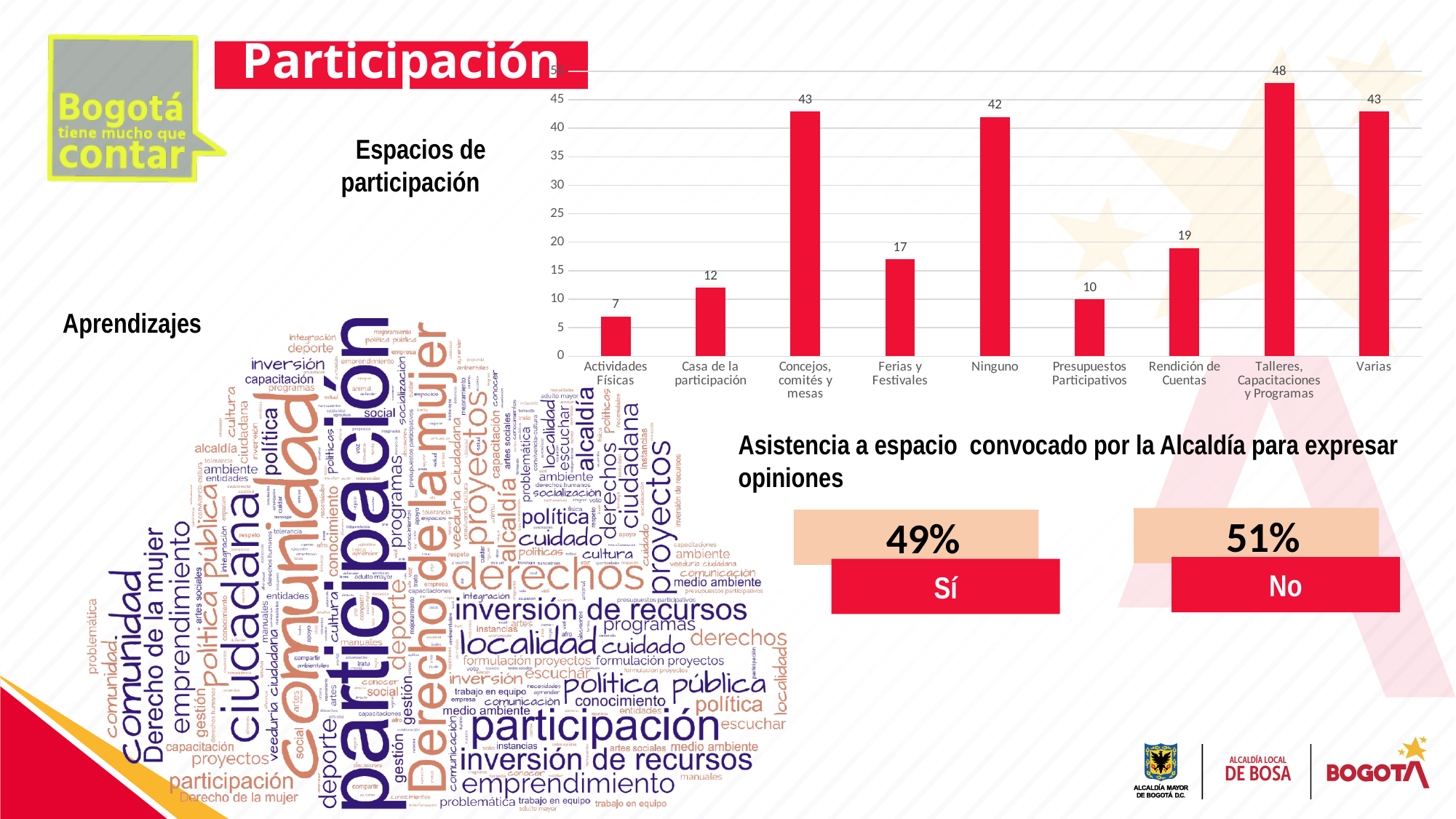
How many categories are shown in the 'Espacios de participación' bar chart? 9 In the 'Espacios de participación' bar chart, what is the difference between the values for Talleres, Capacitaciones y Programas and Casa de la participación? 36 In the 'Asistencia a espacio convocado por la Alcaldía para expresar opiniones' graphic, which is larger: Sí or No? No In the 'Espacios de participación' bar chart, is the value for Varias greater or less than 40? greater In the 'Espacios de participación' bar chart, which category has the lowest value? Actividades Físicas In the 'Espacios de participación' bar chart, what is the value for Presupuestos Participativos? 10 In the 'Espacios de participación' bar chart, what is the value for Ferias y Festivales? 17 In the 'Asistencia a espacio convocado por la Alcaldía para expresar opiniones' graphic, what percentage answered Sí? 49% What kind of chart is the 'Espacios de participación' chart? bar chart In the 'Espacios de participación' bar chart, what is the value for Rendición de Cuentas? 19 In the 'Espacios de participación' bar chart, which is larger: the value for Ninguno or the value for Rendición de Cuentas? Ninguno In the 'Espacios de participación' bar chart, which category has the highest value? Talleres, Capacitaciones y Programas